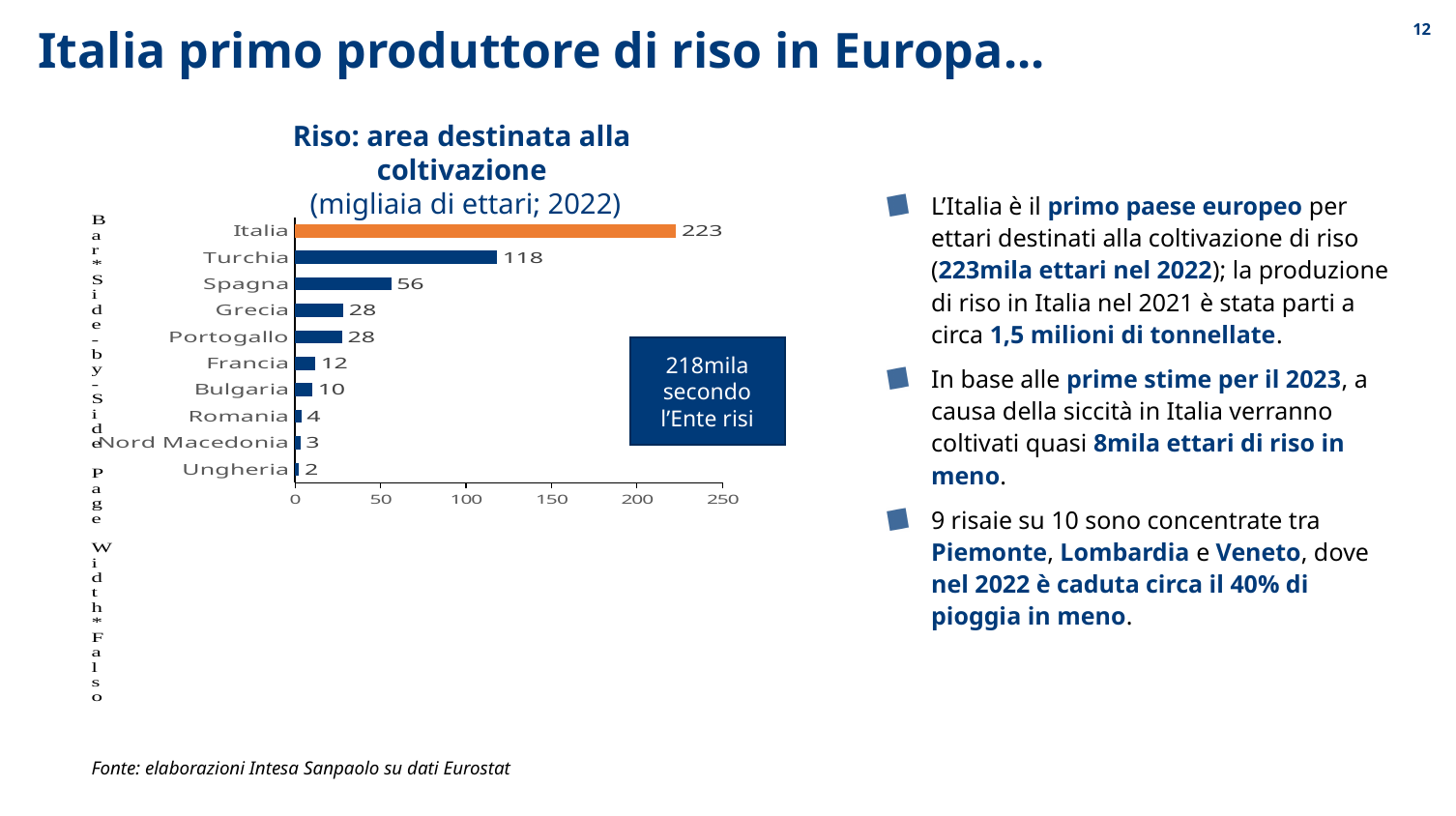
What is the value for Italia in the chart? 223 What is the difference between the values for Italia and Turchia? 105 Which has a larger value, Spagna or Grecia? Spagna Which country has the highest value in the chart? Italia What is the value for Turchia in the chart? 118 What is the title of the chart? Riso: area destinata alla coltivazione (migliaia di ettari; 2022) What is the value for Spagna in the chart? 56 How many countries are shown in the chart? 10 Is the value for Turchia greater or less than 100? greater Which country has the lowest value in the chart? Ungheria What kind of chart is shown on the slide? Bar chart What is the value for Francia in the chart? 12